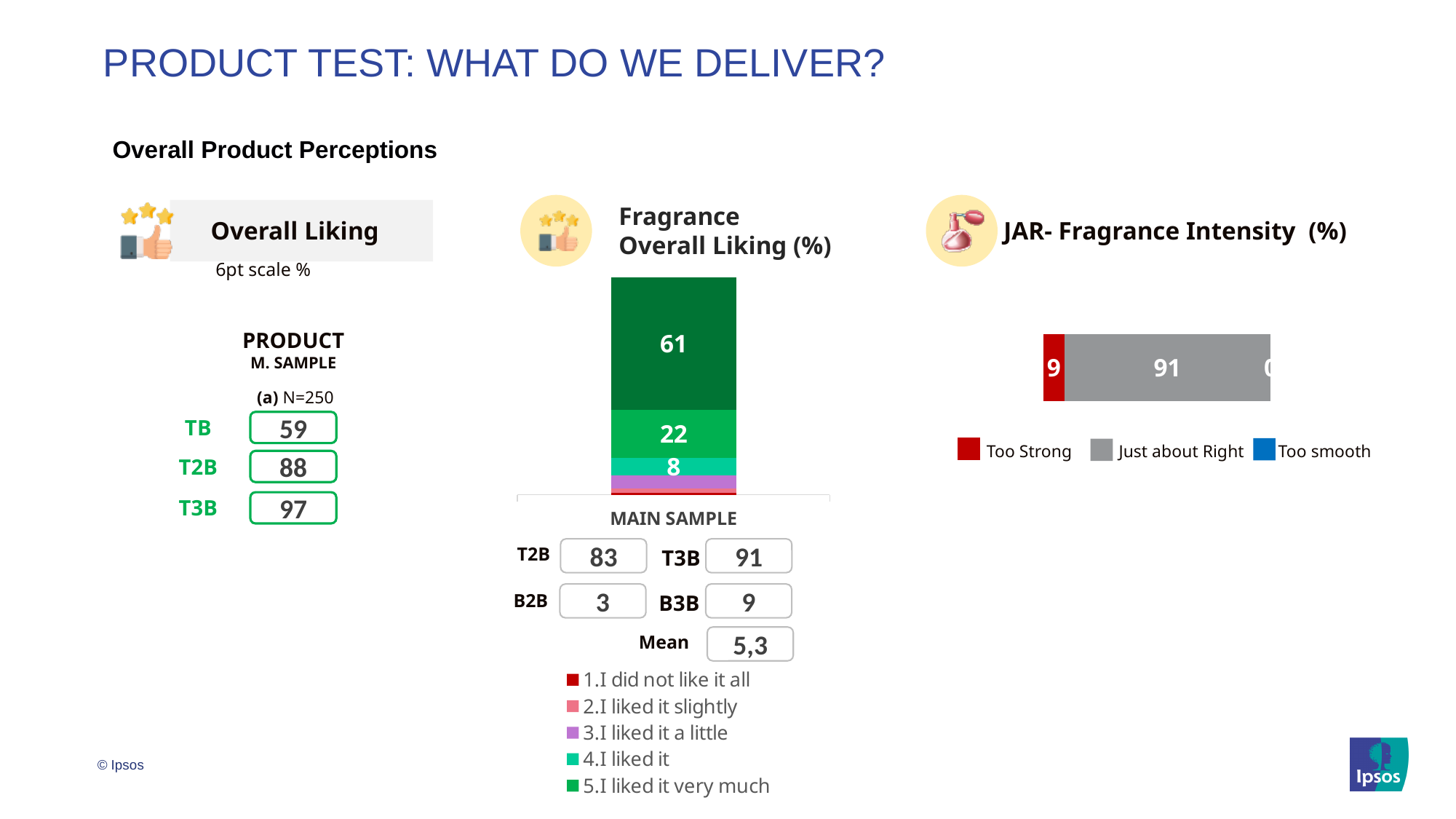
In the Fragrance Overall Liking (%) chart, what value is printed on the top dark green segment of the bar? 61 In the Fragrance Overall Liking (%) chart, what is the difference between the top segment value (61) and the segment labelled 22? 39 What T2B value is shown below the Fragrance Overall Liking (%) chart for the main sample? 83 In the JAR- Fragrance Intensity (%) chart, what is the value for Too Strong? 9 How many entries does the legend of the JAR- Fragrance Intensity (%) chart list? 3 In the JAR- Fragrance Intensity (%) chart, which category has the highest value? Just about Right What type of chart is the Fragrance Overall Liking (%) chart? bar chart How many entries does the legend of the Fragrance Overall Liking (%) chart list? 5 In the JAR- Fragrance Intensity (%) chart, what is the value for Just about Right? 91 In the Fragrance Overall Liking (%) chart, which is larger: the segment labelled 22 or the segment labelled 8? the segment labelled 22 In the JAR- Fragrance Intensity (%) chart, what is the difference between Just about Right and Too Strong? 82 In the Fragrance Overall Liking (%) chart, what value is printed on the segment for '4.I liked it'? 8